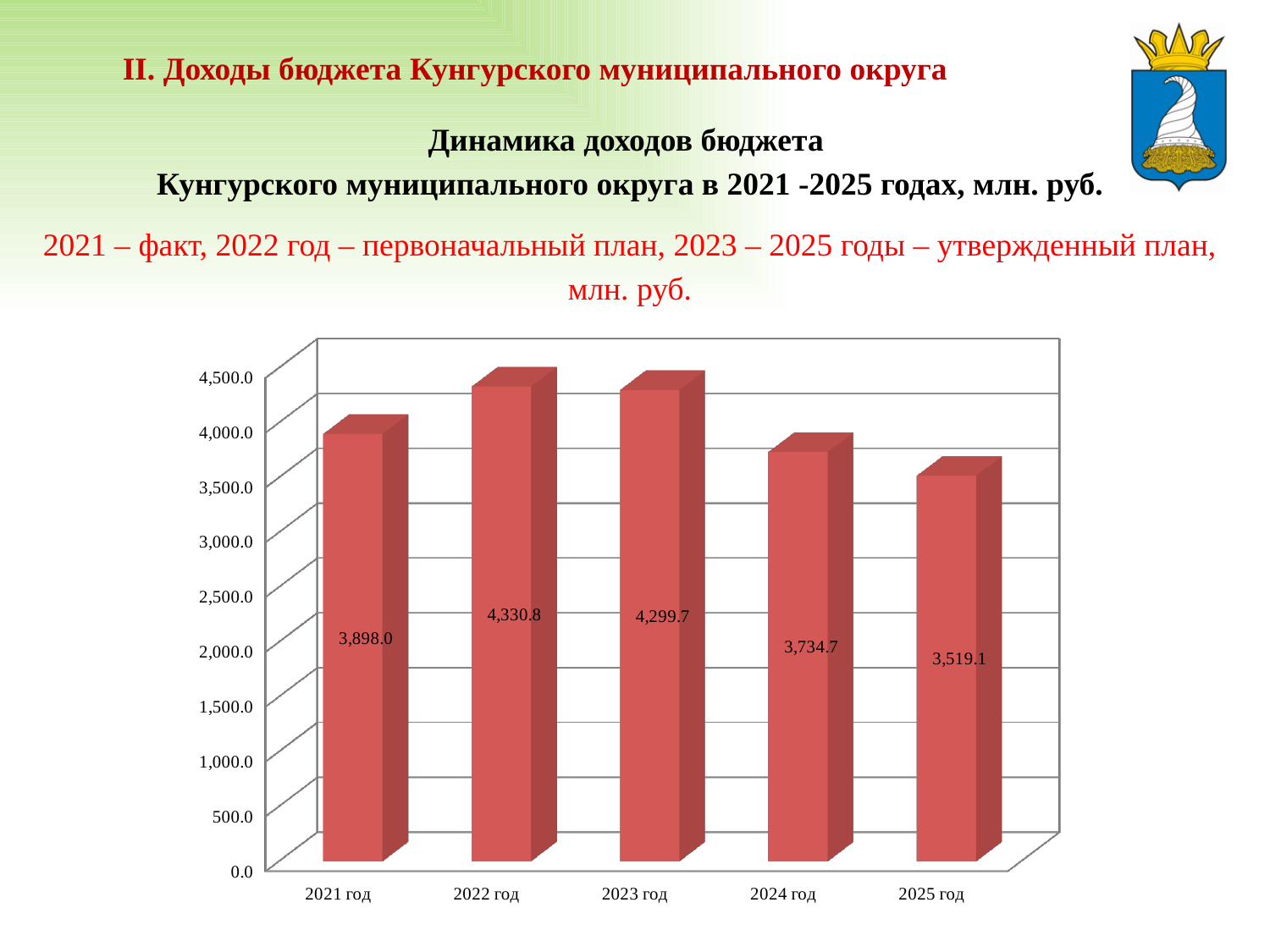
Which year has the highest value? 2022 год How many years are shown on the x axis? 5 What is the difference between the values for 2021 год and 2025 год? 378.9 What is the value for 2024 год? 3,734.7 Which year has the lowest value? 2025 год What kind of chart is shown on the slide? bar chart Is the value for 2024 год greater or less than 4,000.0? less What is the value for 2025 год? 3,519.1 Do the values rise or fall from 2022 год to 2025 год? fall What is the difference between the values for 2022 год and 2023 год? 31.1 What is the value for 2021 год? 3,898.0 Which is larger, the value for 2022 год or the value for 2023 год? 2022 год